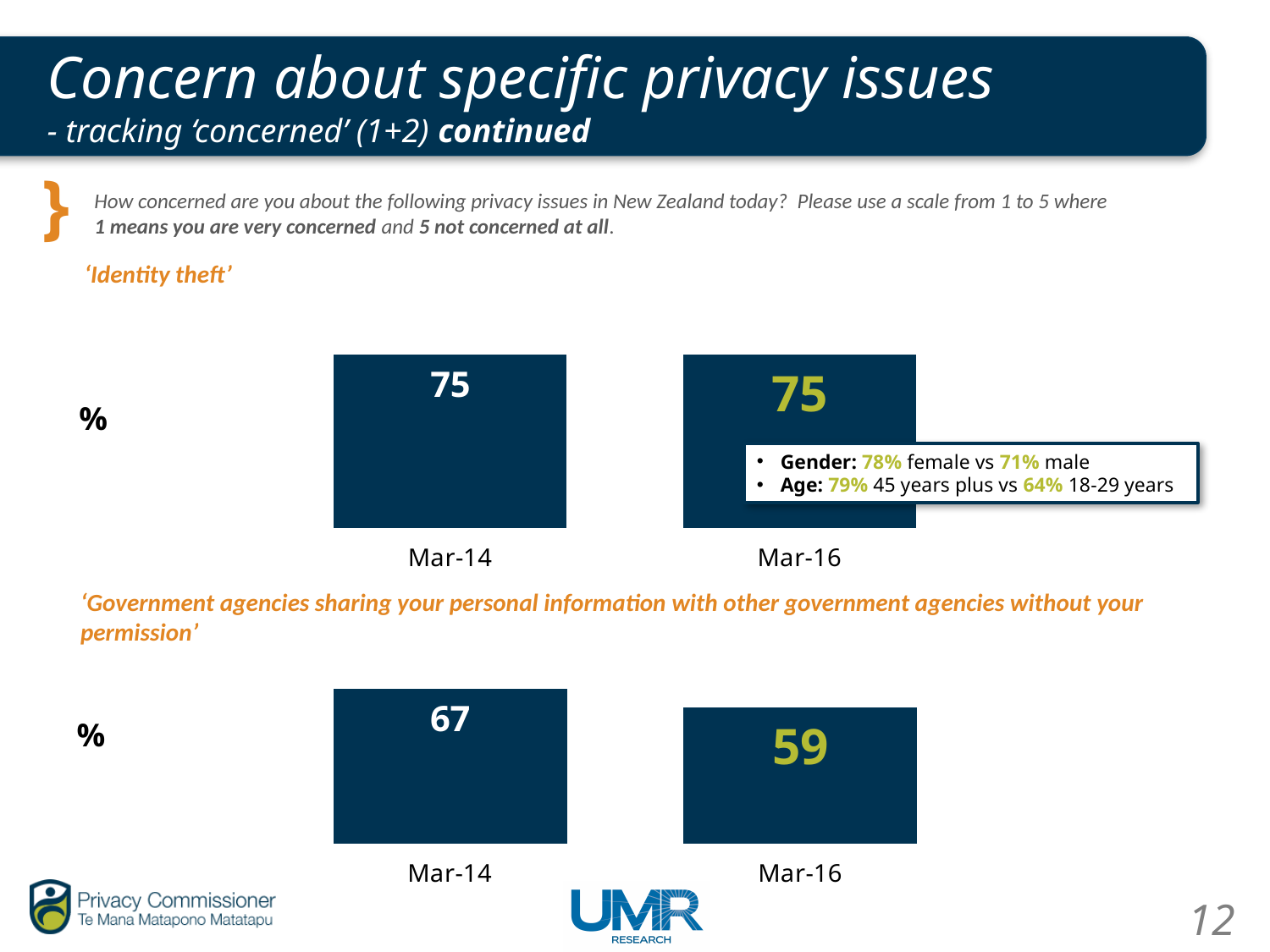
In the 'Government agencies sharing your personal information' chart, what is the value for Mar-16? 59 In the 'Government agencies sharing your personal information' chart, do the values rise or fall from Mar-14 to Mar-16? fall In the 'Identity theft' chart, what is the value for Mar-16? 75 In the 'Identity theft' chart, how many bars are plotted? 2 In the 'Government agencies sharing your personal information' chart, which period has the higher value? Mar-14 In the 'Identity theft' chart, what percentage of 18-29 year olds are concerned according to the annotation? 64% In the 'Government agencies sharing your personal information' chart, what is the value for Mar-14? 67 In the 'Identity theft' chart, what is the value for Mar-14? 75 What kind of chart is the 'Identity theft' chart? bar chart In the 'Government agencies sharing your personal information' chart, what is the difference between the Mar-14 and Mar-16 values? 8 In the 'Government agencies sharing your personal information' chart, is the Mar-16 value greater or less than the Mar-14 value? less In the 'Identity theft' chart, what percentage of females are concerned according to the annotation? 78%